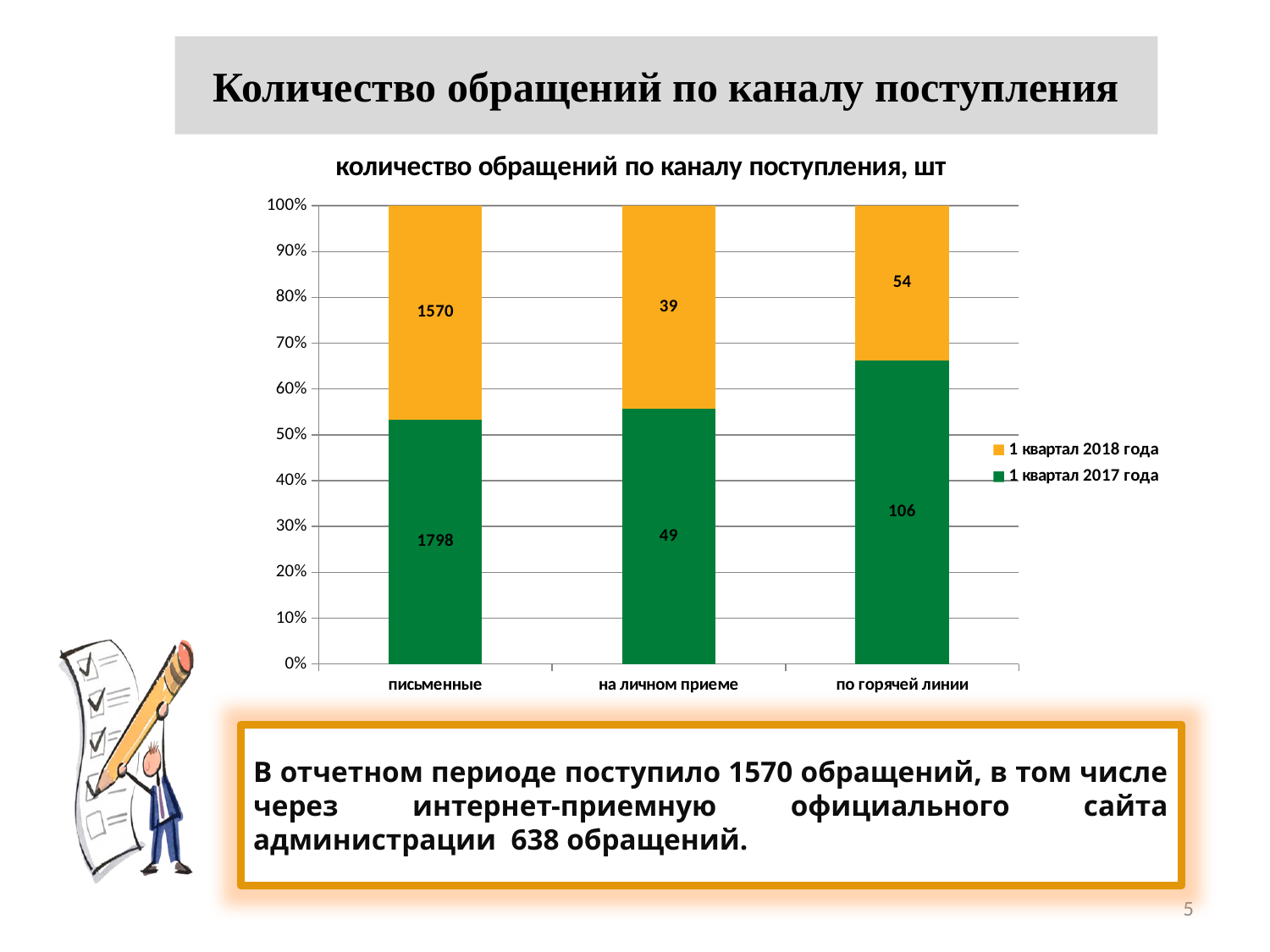
Which category has the highest value in the 1 квартал 2017 года series? письменные What kind of chart is shown on the slide? stacked bar chart What is the value for на личном приеме in the 1 квартал 2018 года series? 39 Is the share of the 1 квартал 2017 года segment for по горячей линии greater or less than 60%? greater Which is larger for по горячей линии: the 1 квартал 2017 года value or the 1 квартал 2018 года value? 1 квартал 2017 года What is the difference between the 1 квартал 2017 года and 1 квартал 2018 года values for письменные? 228 What is the value for письменные in the 1 квартал 2017 года series? 1798 What is the total of the two values stacked for по горячей линии? 160 How many categories are shown on the x axis? 3 What is the value for по горячей линии in the 1 квартал 2018 года series? 54 Which category has the lowest value in the 1 квартал 2018 года series? на личном приеме How many series does the legend list? 2